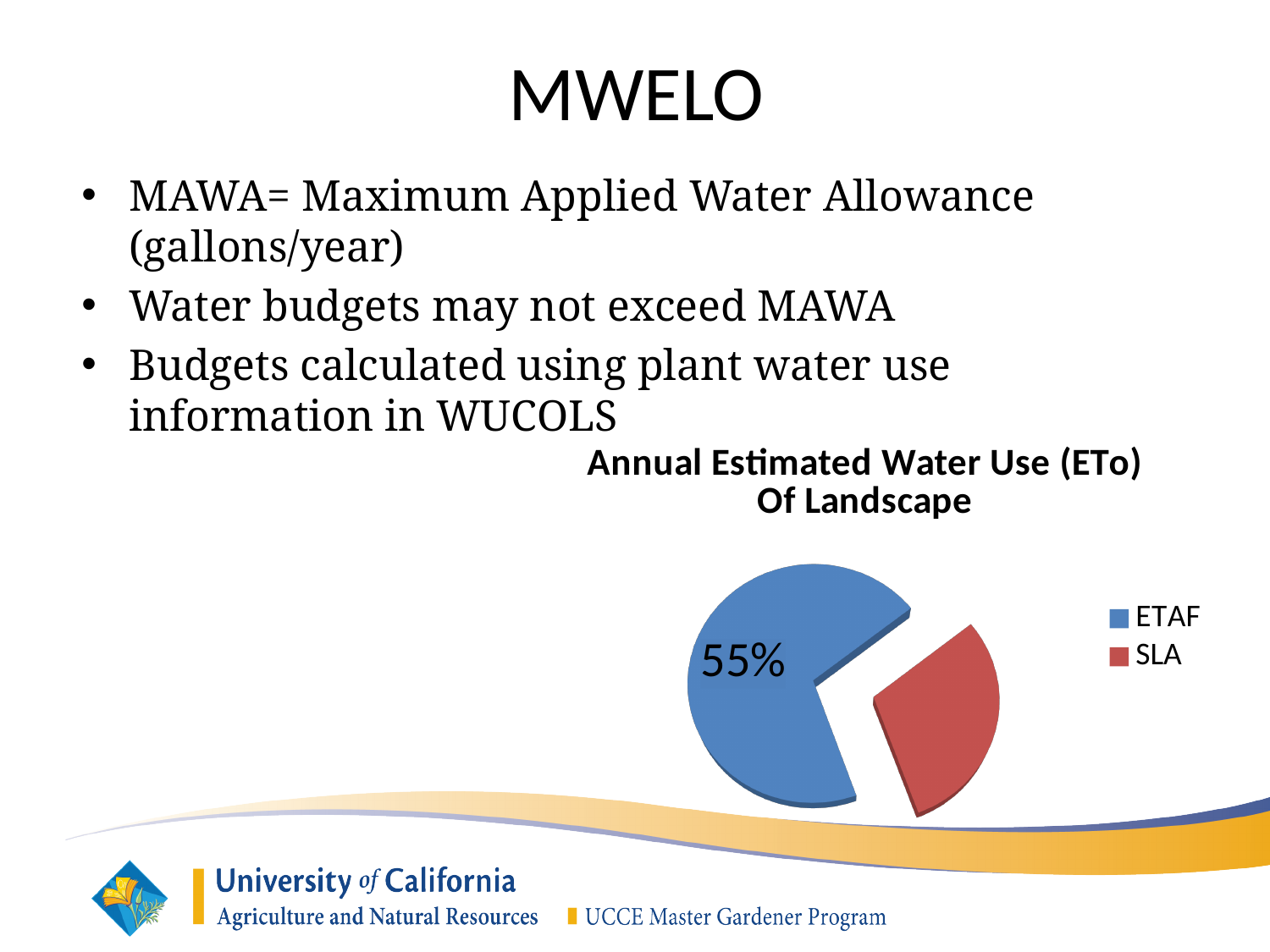
What colour is the ETAF slice? blue Which is larger, the ETAF slice or the SLA slice? ETAF Is the ETAF share of the pie greater or less than 50%? greater How many slices does the pie chart have? 2 What kind of chart is shown on the slide? pie chart Which slice of the pie is the smallest? SLA How many entries does the legend list? 2 What is the title of the chart? Annual Estimated Water Use (ETo) Of Landscape Which slice of the pie is the largest? ETAF